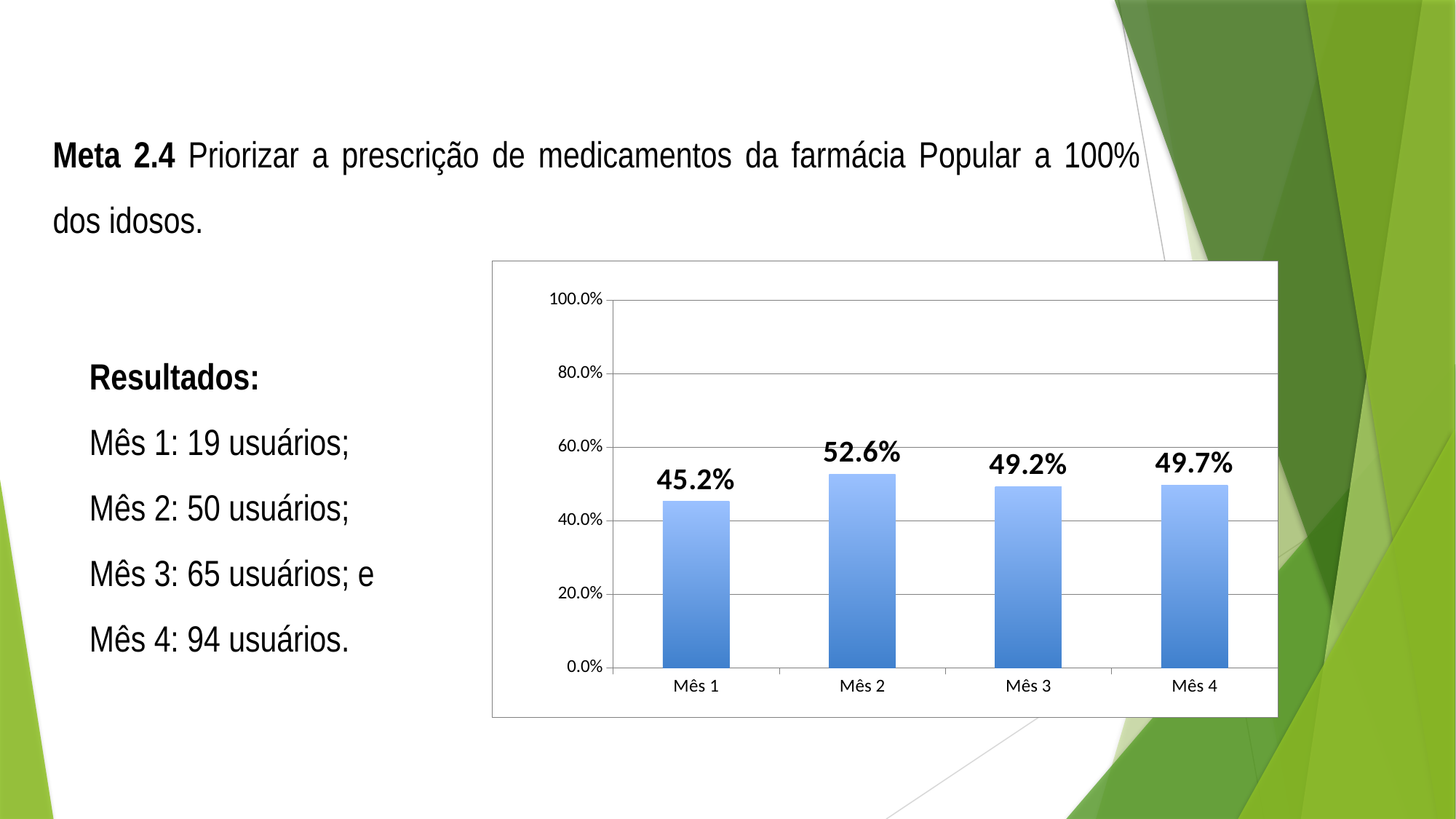
Is the value for Mês 1 greater or less than 60%? less Which month has the highest value? Mês 2 What kind of chart is shown on the slide? bar chart What is the value for Mês 4? 49.7% How many months are shown on the x axis of the chart? 4 What is the value for Mês 1? 45.2% What is the difference between the values for Mês 2 and Mês 1? 7.4% What is the value for Mês 3? 49.2% Which month has the lowest value? Mês 1 What is the highest tick value shown on the y axis? 100.0% What is the value for Mês 2? 52.6% Which is larger, the value for Mês 2 or the value for Mês 3? Mês 2